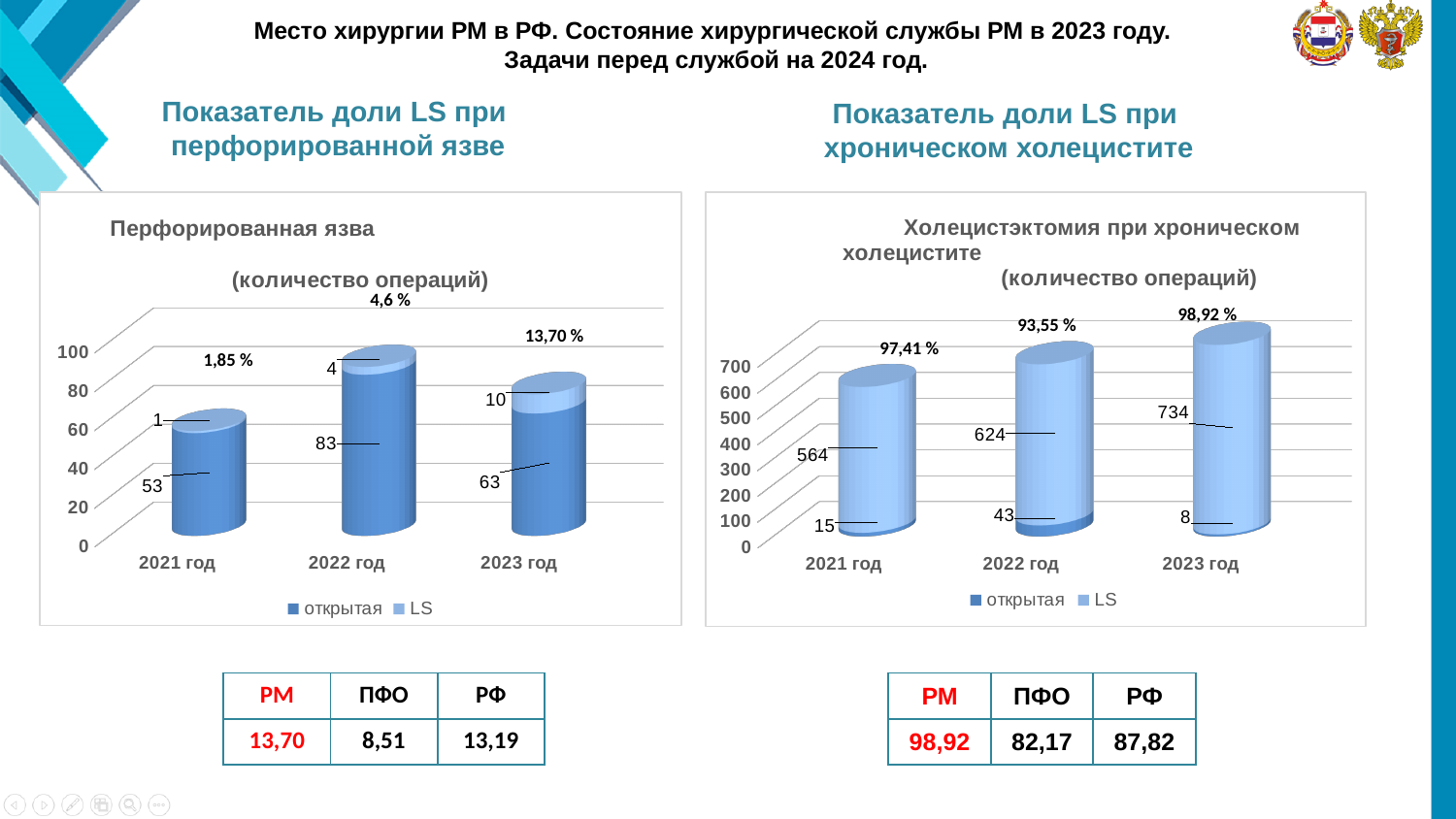
In the chart 'Перфорированная язва', what percentage is shown above the bar for 2021 год? 1,85 % In the chart 'Перфорированная язва', what is the total of the stacked bar for 2022 год? 87 What kind of chart is 'Холецистэктомия при хроническом холецистите'? stacked bar chart In the chart 'Перфорированная язва', which year has the highest 'открытая' value? 2022 год In the chart 'Перфорированная язва', what is the value of the 'открытая' series for 2022 год? 83 In the chart 'Холецистэктомия при хроническом холецистите', which year has the lowest 'открытая' value? 2023 год In the chart 'Перфорированная язва', how many series does the legend list? 2 In the chart 'Холецистэктомия при хроническом холецистите', does the 'LS' value rise or fall from 2021 год to 2023 год? rise In the chart 'Перфорированная язва', what is the value of the 'LS' series for 2023 год? 10 In the chart 'Холецистэктомия при хроническом холецистите', what is the value of the 'открытая' series for 2022 год? 43 In the chart 'Холецистэктомия при хроническом холецистите', what is the value of the 'LS' series for 2021 год? 564 In the chart 'Холецистэктомия при хроническом холецистите', what is the difference between the 'LS' values for 2023 год and 2022 год? 110